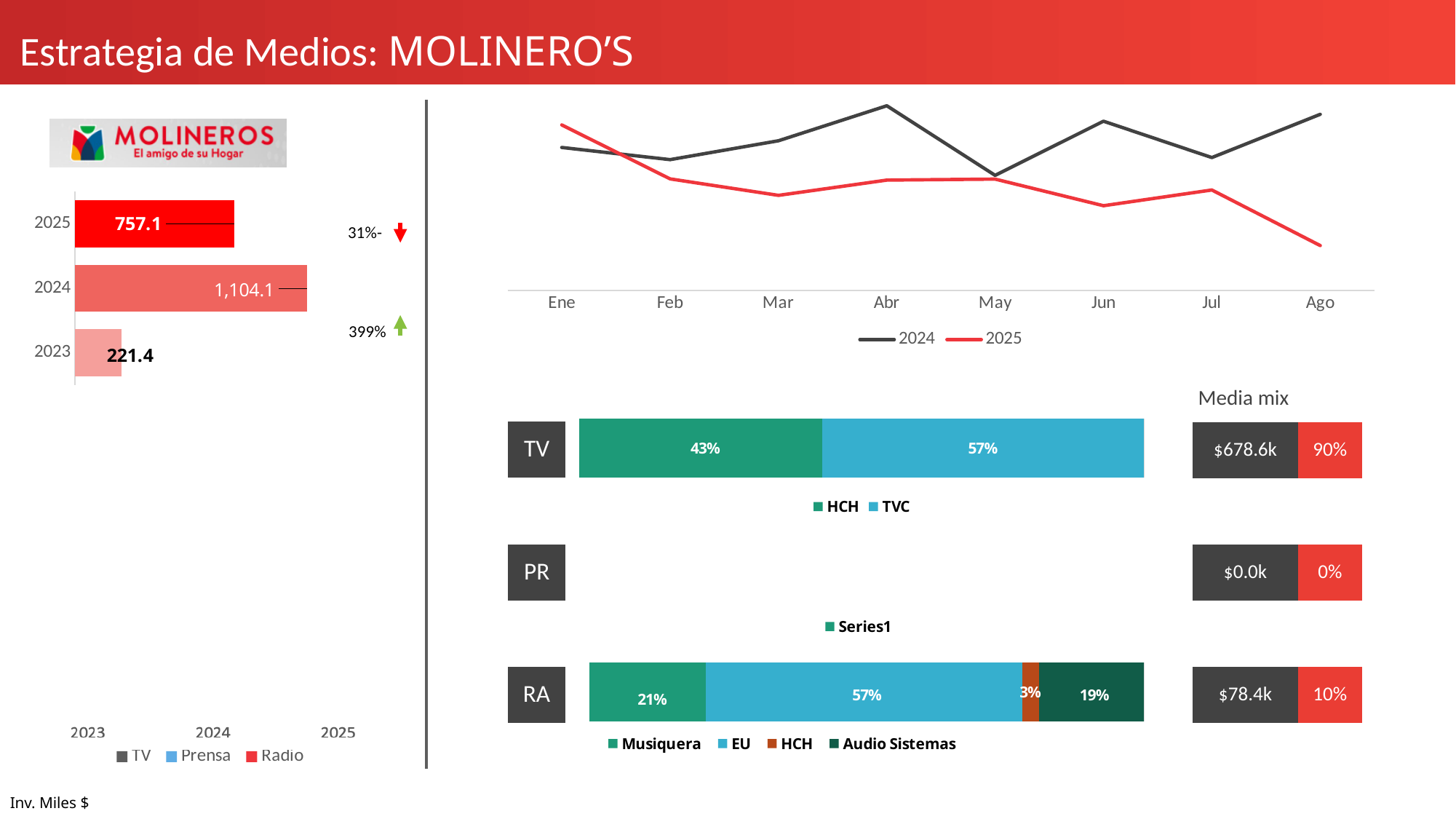
In the line chart at the top right, how many series does the legend list? 2 In the horizontal bar chart on the left, what is the value for 2024? 1,104.1 In the line chart at the top right, how many months are shown on the x axis? 8 In the line chart at the top right, which series is higher in Ago, 2024 or 2025? 2024 In the line chart at the top right, does the 2025 line rise or fall from Jul to Ago? fall In the horizontal bar chart on the left, what is the value for 2023? 221.4 In the horizontal bar chart on the left, what is the difference between the 2024 and 2025 values? 347.0 In the horizontal bar chart on the left, which year has the highest value? 2024 In the horizontal bar chart on the left, which year has the lowest value? 2023 In the RA stacked bar, what share does Audio Sistemas have? 19% In the TV stacked bar, what share does TVC have? 57% In the Media mix column, what is the amount shown for RA? $78.4k